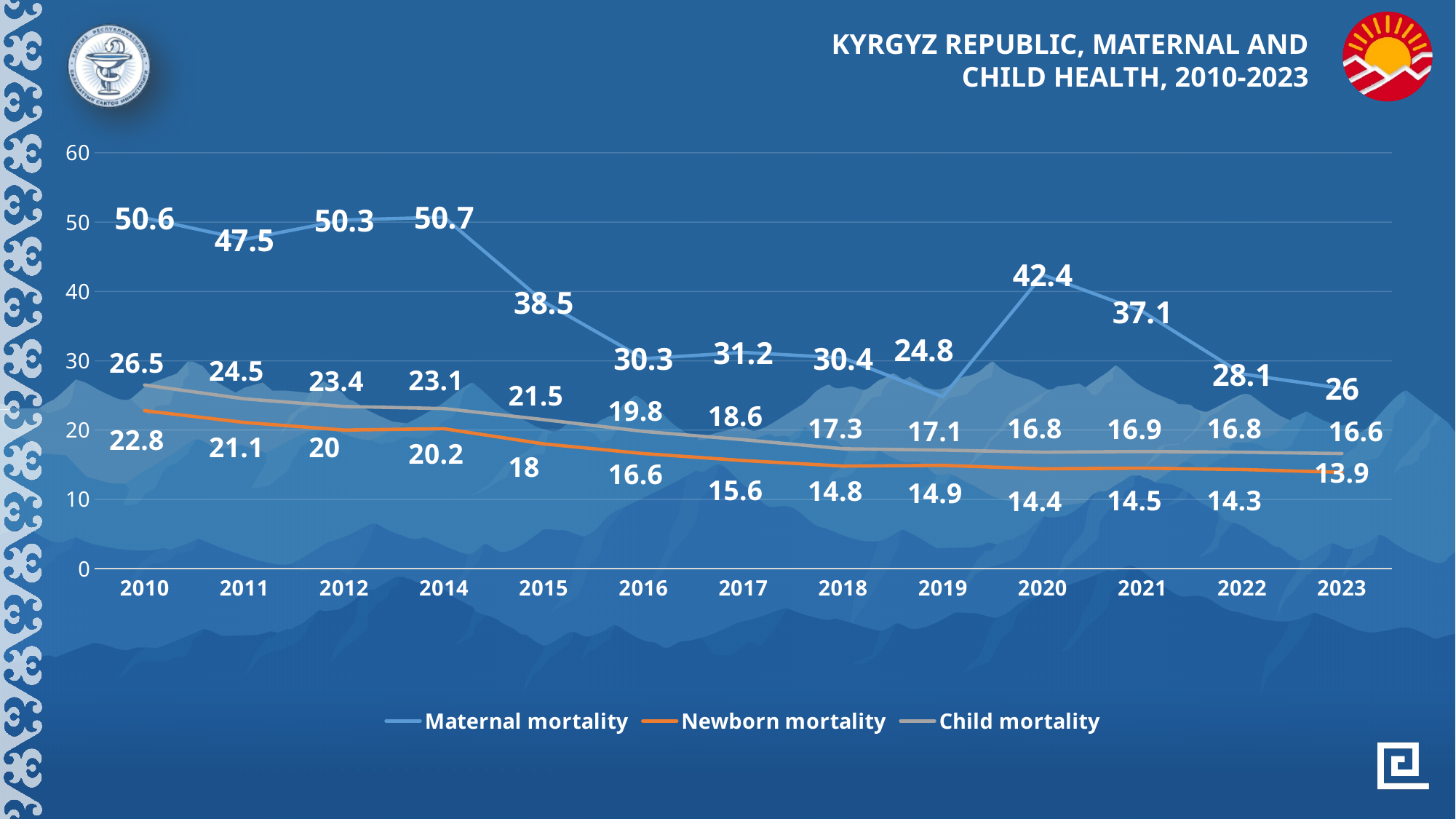
How many series does the legend list? 3 What is the newborn mortality value for 2023? 13.9 What is the child mortality value for 2018? 17.3 How many years are shown on the x axis? 13 Which year has the higher maternal mortality, 2020 or 2021? 2020 What kind of chart is shown on the slide? Line chart In which year is maternal mortality highest? 2014 What is the difference between maternal mortality in 2010 and in 2023? 24.6 What is the maternal mortality value for 2015? 38.5 In which year is newborn mortality lowest? 2023 Does child mortality rise or fall from 2010 to 2023? Fall What is the difference between child mortality and newborn mortality in 2010? 3.7